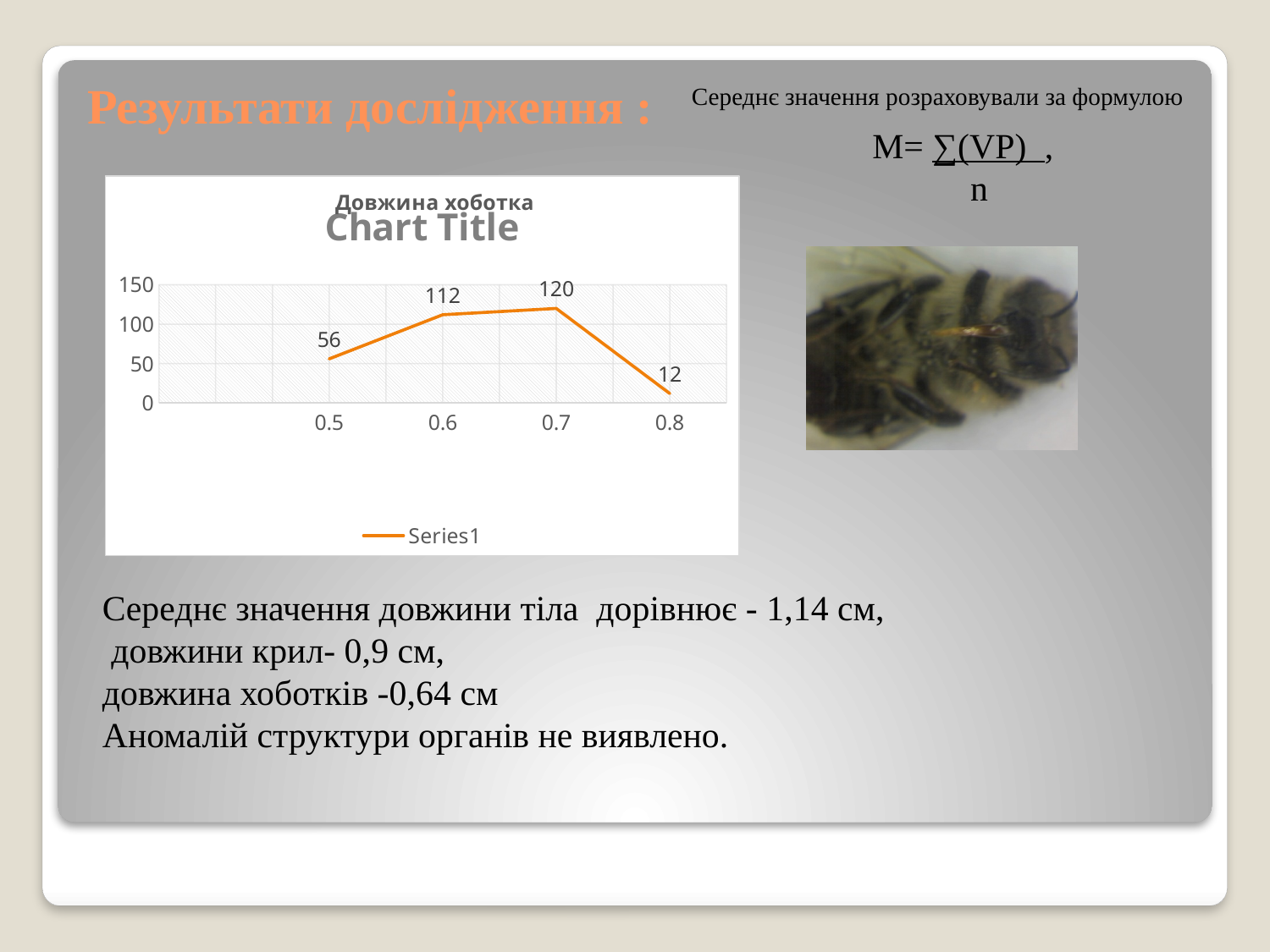
What is the value for 0.8 in the chart? 12 What is the difference between the values for 0.7 and 0.6? 8 Which category has the lowest value in the chart? 0.8 What is the difference between the values for 0.5 and 0.8? 44 How many series does the legend list? 1 How many data points are plotted in the chart? 4 Which is larger, the value for 0.6 or the value for 0.5? 0.6 What is the value for 0.7 in the chart? 120 Which category has the highest value in the chart? 0.7 What is the value for 0.5 in the chart? 56 What kind of chart is shown on the slide? line chart What is the name of the series shown in the legend? Series1